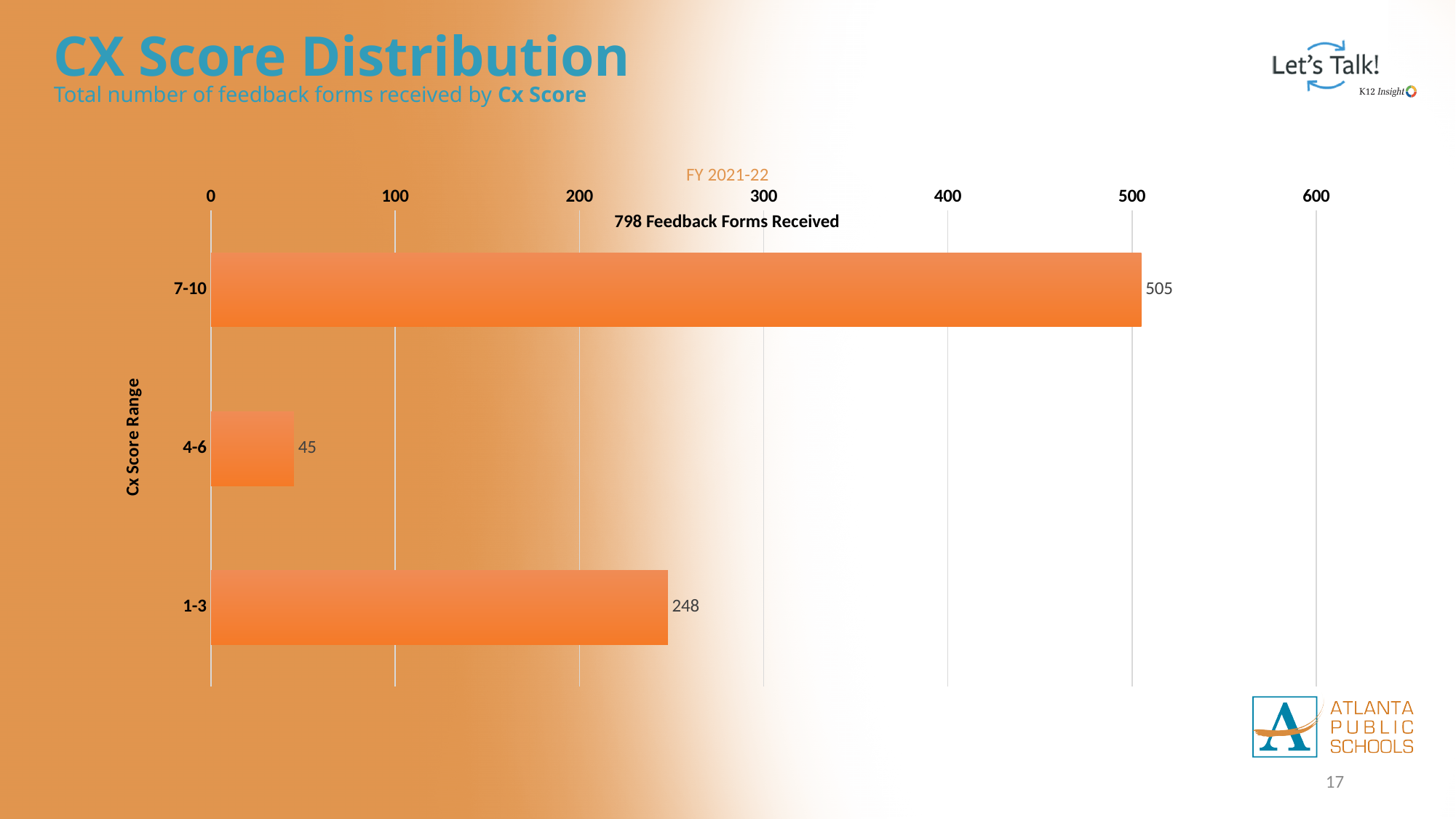
Which received more feedback forms, the 1-3 range or the 4-6 range? 1-3 How many feedback forms were received with a Cx Score of 7-10? 505 What is the label on the vertical axis of the chart? Cx Score Range Is the value for the 1-3 range greater or less than 300? less What is the difference between the number of feedback forms for the 1-3 range and the 4-6 range? 203 How many feedback forms were received with a Cx Score of 4-6? 45 How many Cx Score ranges are shown in the chart? 3 How many feedback forms were received with a Cx Score of 1-3? 248 What kind of chart is shown on the slide? bar chart Which Cx Score range received the most feedback forms? 7-10 Which Cx Score range received the fewest feedback forms? 4-6 What is the difference between the number of feedback forms for the 7-10 range and the 1-3 range? 257